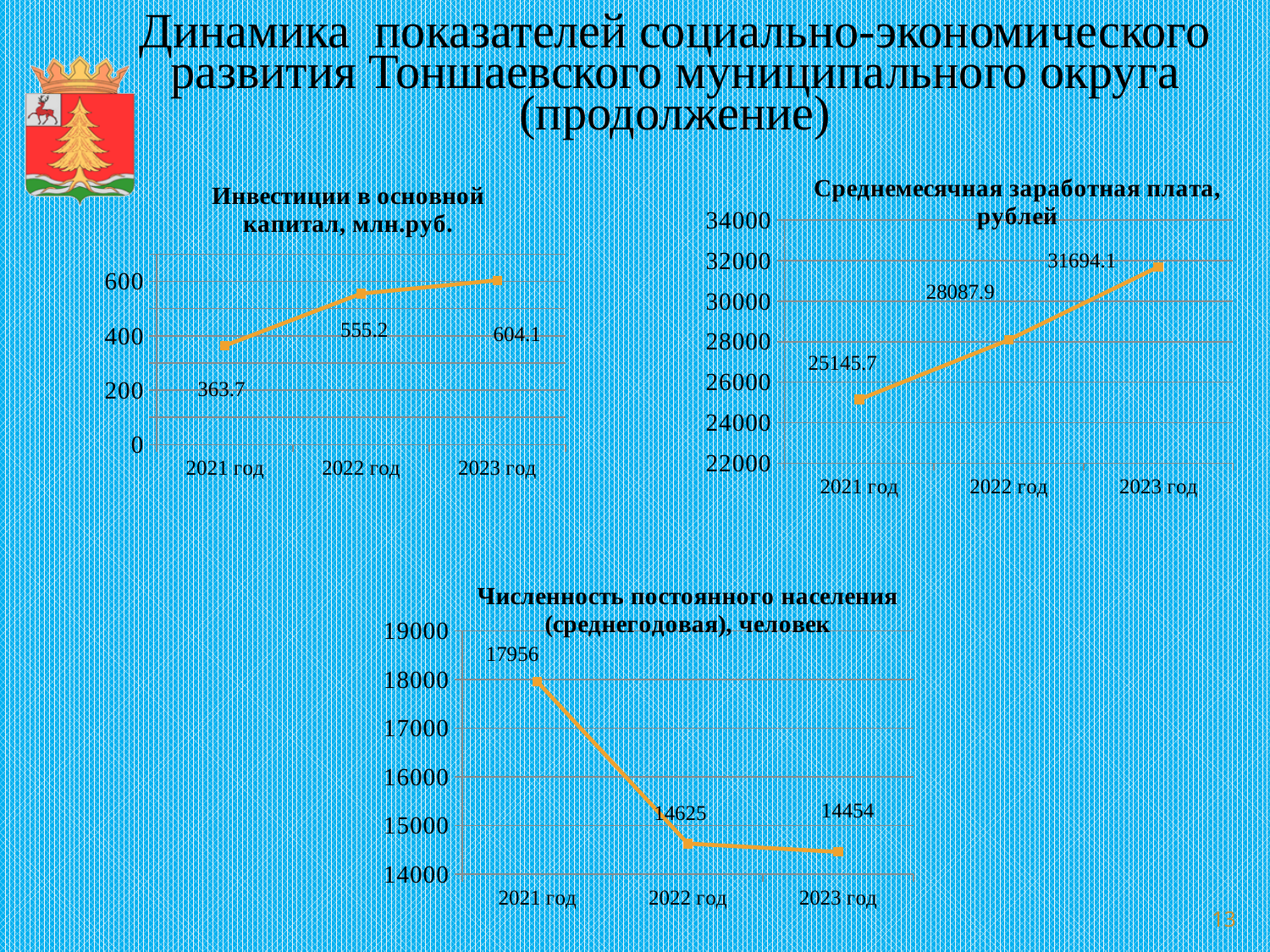
On the chart 'Численность постоянного населения (среднегодовая), человек', what is the difference between the 2021 год and 2023 год values? 3502 On the chart 'Численность постоянного населения (среднегодовая), человек', which is larger, the value for 2022 год or 2023 год? 2022 год On the chart 'Инвестиции в основной капитал, млн.руб.', what is the value for 2021 год? 363.7 On the chart 'Среднемесячная заработная плата, рублей', which year has the lowest value? 2021 год On the chart 'Численность постоянного населения (среднегодовая), человек', what is the value for 2021 год? 17956 On the chart 'Инвестиции в основной капитал, млн.руб.', do the values rise or fall from 2021 год to 2023 год? rise What type of chart is 'Численность постоянного населения (среднегодовая), человек'? line chart On the chart 'Инвестиции в основной капитал, млн.руб.', which year has the highest value? 2023 год On the chart 'Среднемесячная заработная плата, рублей', what is the difference between the 2023 год and 2021 год values? 6548.4 On the chart 'Среднемесячная заработная плата, рублей', what is the value for 2022 год? 28087.9 On the chart 'Численность постоянного населения (среднегодовая), человек', how many years are plotted? 3 On the chart 'Инвестиции в основной капитал, млн.руб.', what is the difference between the 2023 год and 2021 год values? 240.4